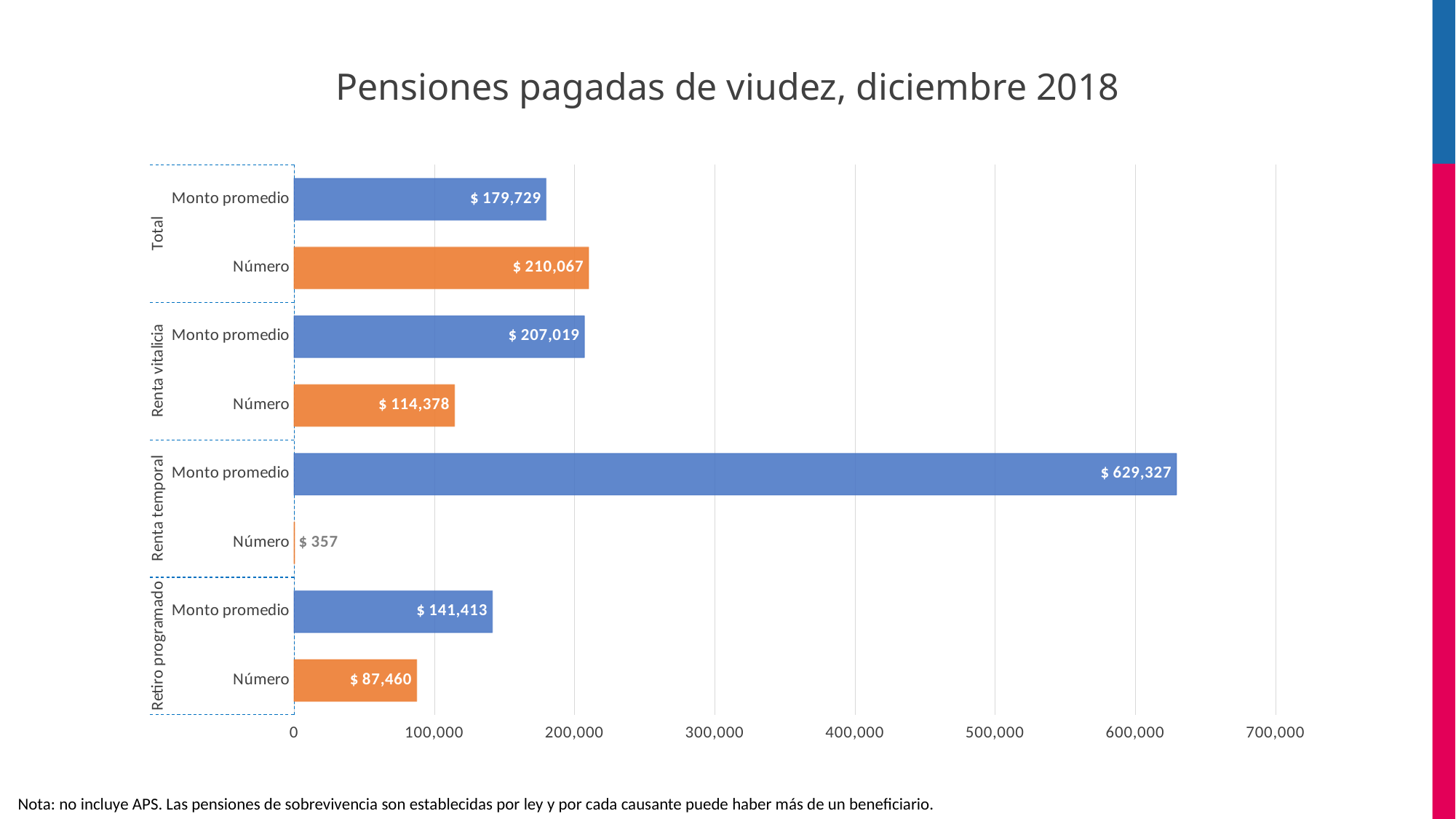
What is the difference between the Monto promedio for Renta vitalicia and the Monto promedio for Retiro programado? $ 65,606 What is the title of the chart? Pensiones pagadas de viudez, diciembre 2018 What is the Número value for Retiro programado? $ 87,460 What is the Monto promedio value for Renta temporal? $ 629,327 What is the Número value for Renta vitalicia? $ 114,378 What is the difference between the Número for Renta vitalicia and the Número for Retiro programado? $ 26,918 Which bar has the lowest value on the chart? Renta temporal, Número Which bar has the highest value on the chart? Renta temporal, Monto promedio What is the Monto promedio value for Total? $ 179,729 What kind of chart is shown on the slide? Bar chart How many bars are plotted on the chart? 8 Which is larger: the Número for Total or the Monto promedio for Total? Número for Total